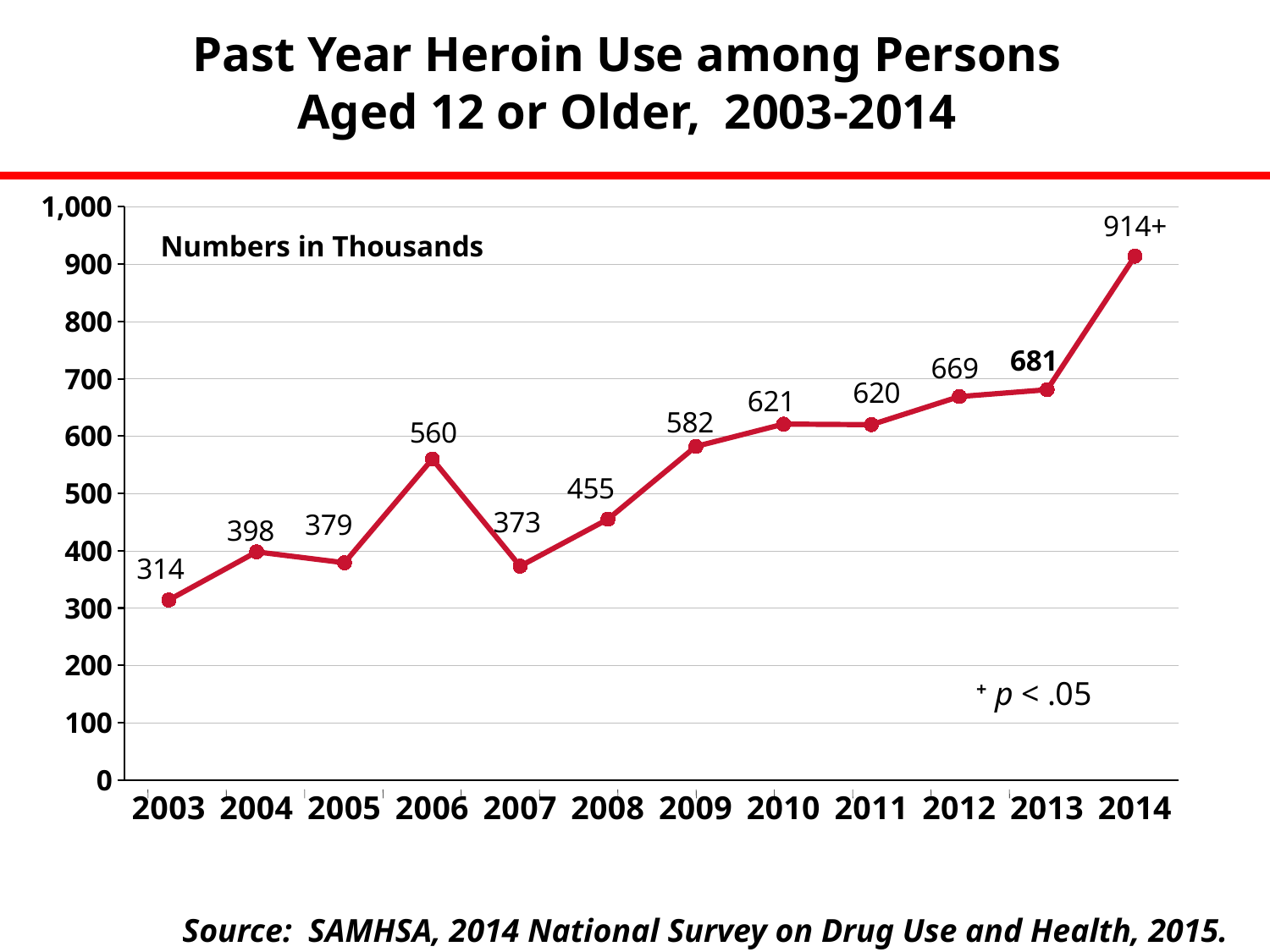
Which year has the lowest value? 2003 Is the value for 2012 greater or less than 600? greater What is the value for 2003? 314 How many years are plotted on the chart? 12 Which year has the highest value? 2014 What is the difference between the values for 2009 and 2008? 127 Do the values generally rise or fall from 2003 to 2014? rise What is the value for 2011? 620 In what units are the numbers on the chart expressed? Thousands Which is larger, the value for 2006 or the value for 2007? 2006 What is the value for 2006? 560 What kind of chart is shown on the slide? line chart